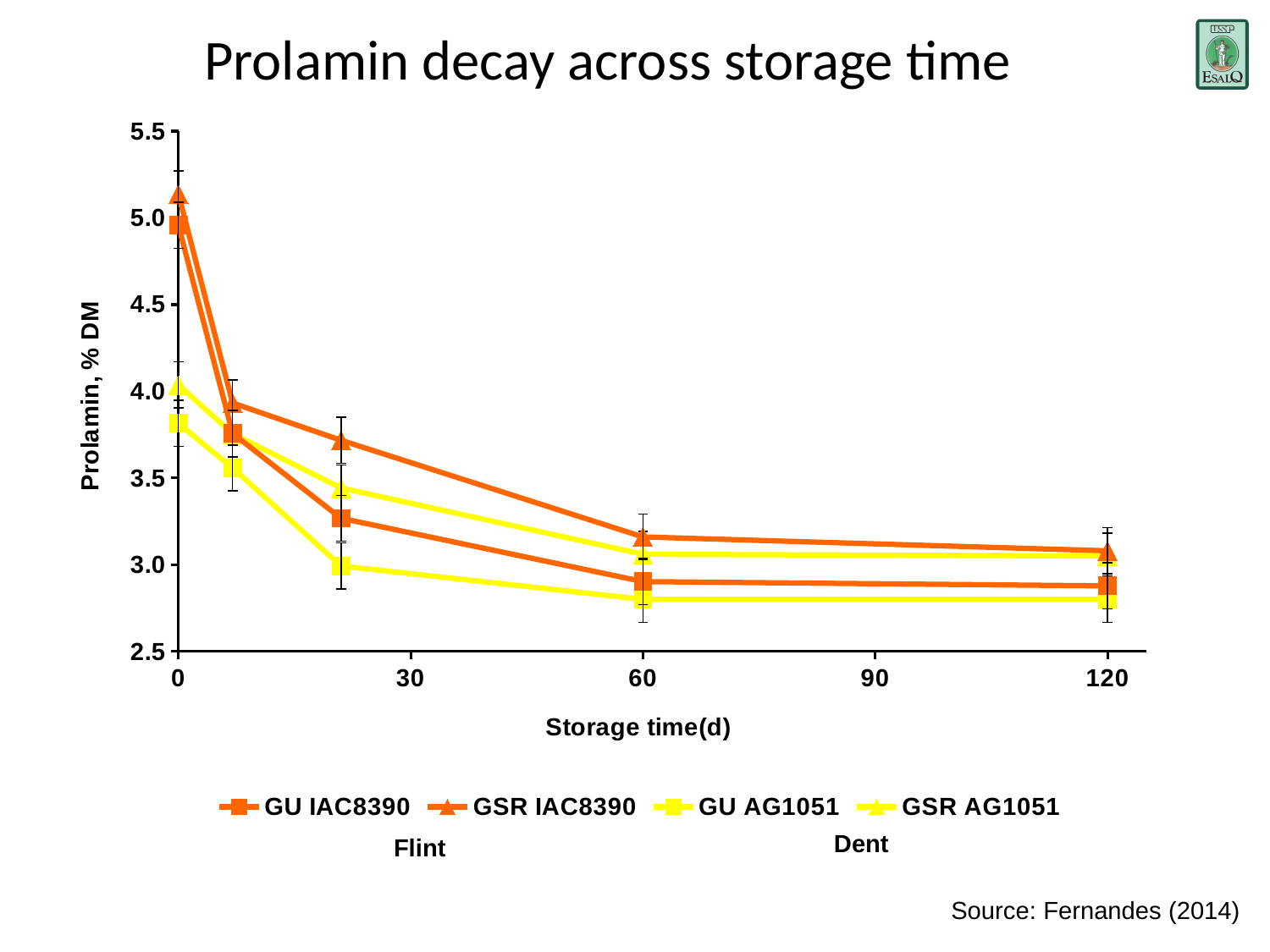
Is the value for GU AG1051 at storage time 120 greater or less than 3.0? less Is the value for GSR IAC8390 at storage time 120 greater or less than 3.5? less Is the value for GSR IAC8390 at storage time 0 greater or less than 4.5? greater What is the label of the y axis? Prolamin, % DM What kind of chart is shown on the slide? line chart What is the title of the chart? Prolamin decay across storage time At storage time 60, which is larger: the value for GSR IAC8390 or the value for GU AG1051? GSR IAC8390 How many series does the legend list? 4 Which series has the highest prolamin value at storage time 0? GSR IAC8390 Do the prolamin values rise or fall as storage time increases? fall Which series has the lowest prolamin value at storage time 0? GU AG1051